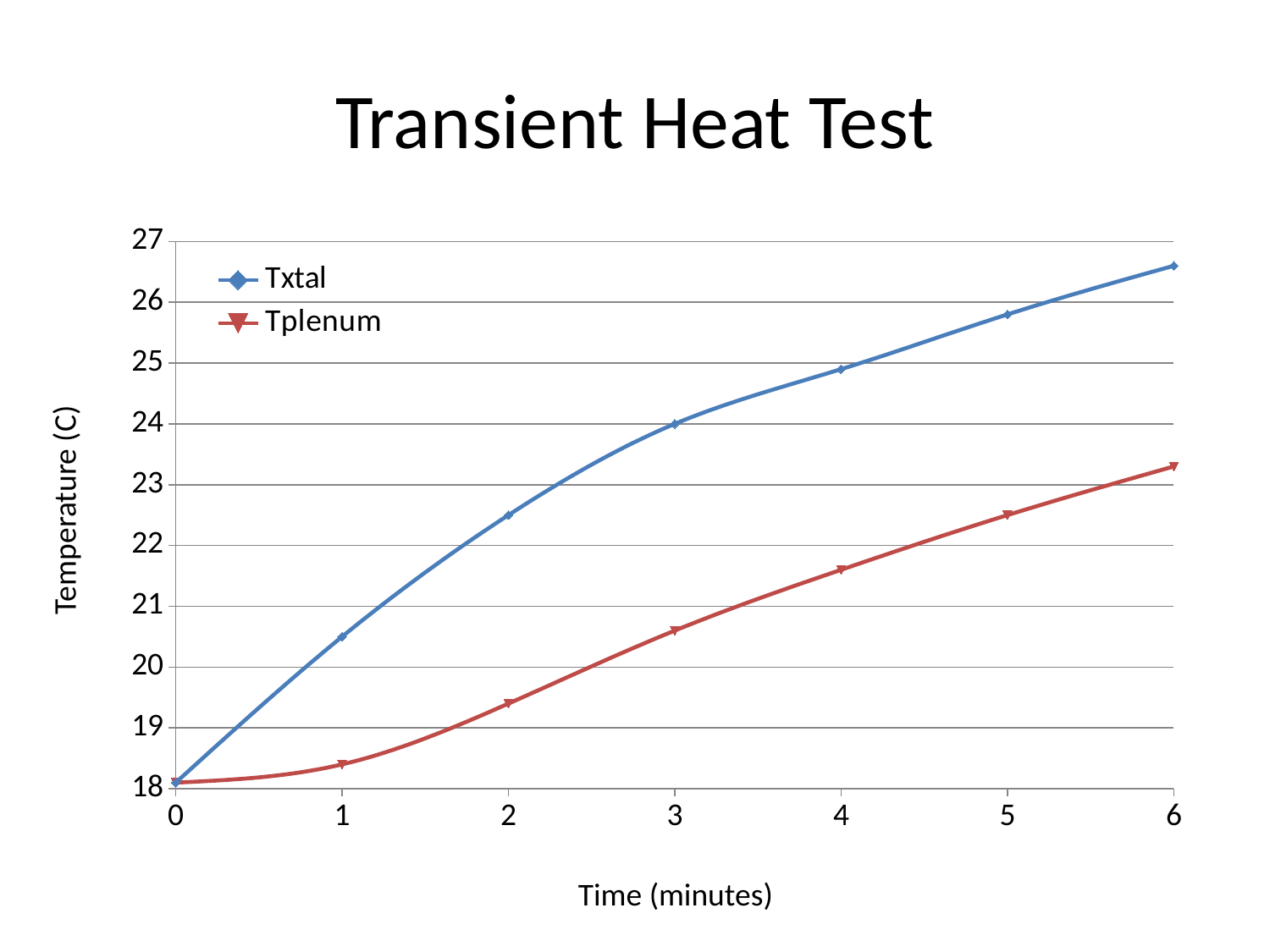
At which time does Txtal reach its highest value? 6 What is the Txtal value at 3 minutes? 24 Do the Tplenum values rise or fall as time increases? rise How many time points are plotted for each series? 7 Is the Tplenum value at 2 minutes greater or less than 20? less What kind of chart is shown on the slide? line chart What is the title of the chart? Transient Heat Test At 4 minutes, which series has the higher temperature, Txtal or Tplenum? Txtal How many series does the legend list? 2 Is the Tplenum value at 6 minutes greater or less than 23? greater What is the label of the y axis? Temperature (C) Is the Txtal value at 6 minutes greater or less than 26? greater